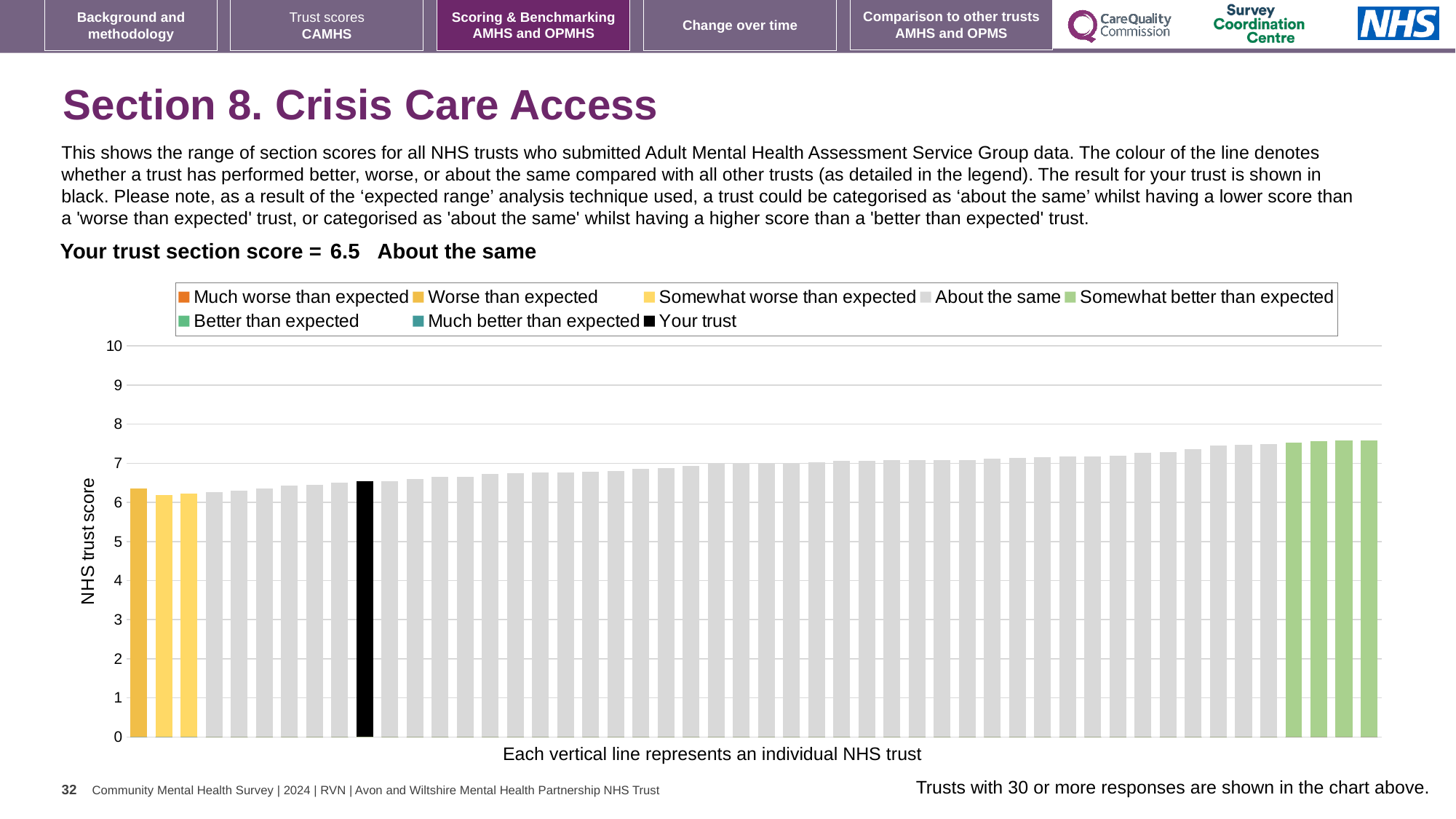
What is the section score for your trust shown on the slide? 6.5 Is the value of the shortest bar greater or less than 5? greater What kind of chart is shown on the slide? bar chart Which legend category do the tallest bars on the right of the chart belong to? Somewhat better than expected How many bars are coloured green (Somewhat better than expected)? 4 What is the label on the y axis of the chart? NHS trust score Do the bar values rise or fall from left to right along the x axis? rise What colour is the bar representing your trust? black How many entries does the chart legend list? 8 Is the value of the tallest bar greater or less than 8? less Which category is your trust placed in for this section? About the same Is the value for your trust greater or less than 6? greater